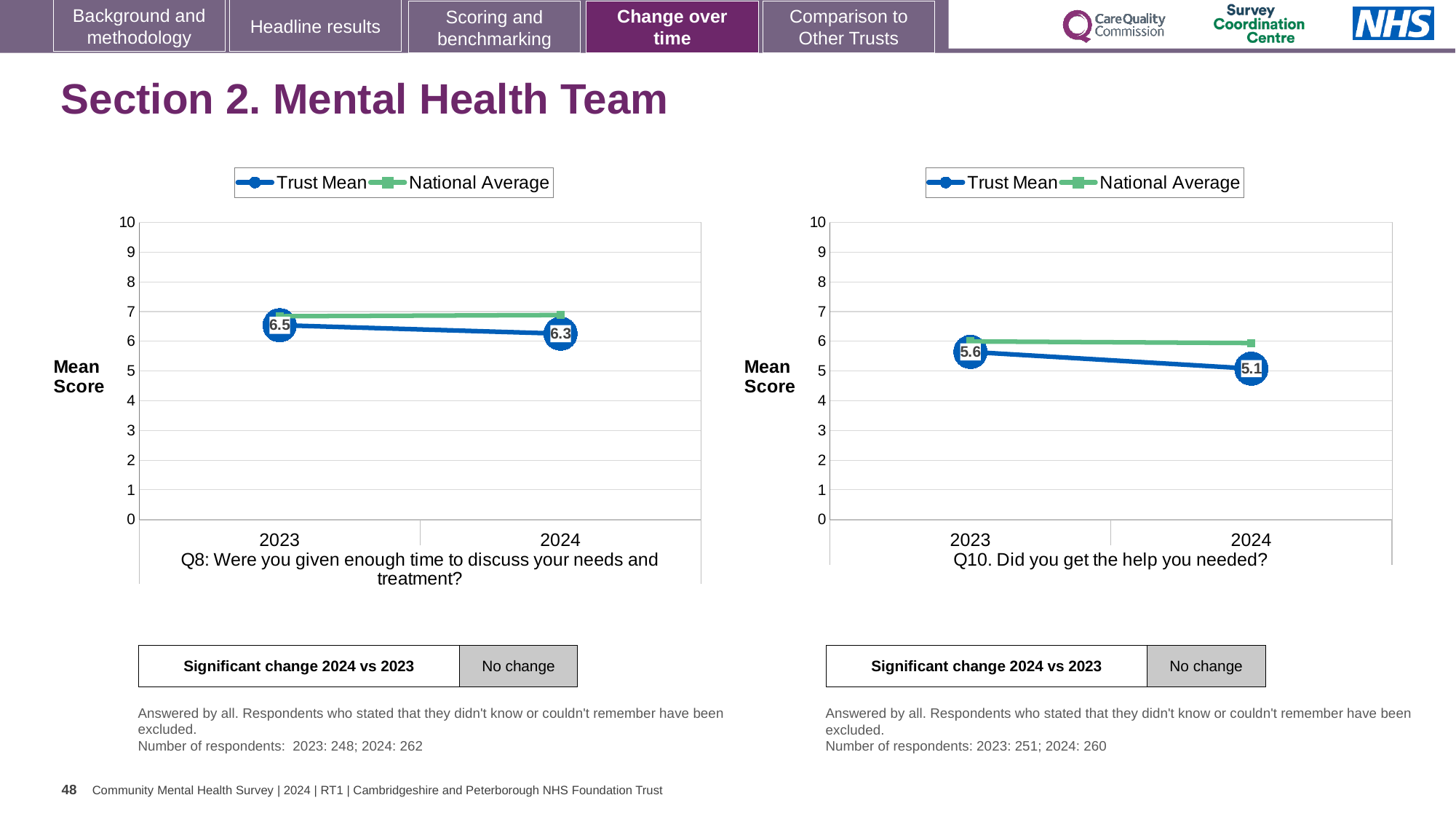
In the left chart (Q8), what is the Trust Mean for 2024? 6.3 In the right chart (Q10), which is larger in 2024, the Trust Mean or the National Average? National Average What kind of chart is the right chart (Q10)? line chart In the left chart (Q8: Were you given enough time to discuss your needs and treatment?), what is the Trust Mean for 2023? 6.5 In the left chart (Q8), what is the difference between the Trust Mean in 2023 and in 2024? 0.2 In the left chart (Q8), is the National Average for 2023 greater or less than 6? greater How many years are shown on the x axis of the right chart (Q10)? 2 In the right chart (Q10. Did you get the help you needed?), what is the Trust Mean for 2023? 5.6 In the left chart (Q8), does the Trust Mean rise or fall from 2023 to 2024? fall In the right chart (Q10), by how much did the Trust Mean fall from 2023 to 2024? 0.5 How many series does the legend of the left chart (Q8) list? 2 In the right chart (Q10), what is the Trust Mean for 2024? 5.1